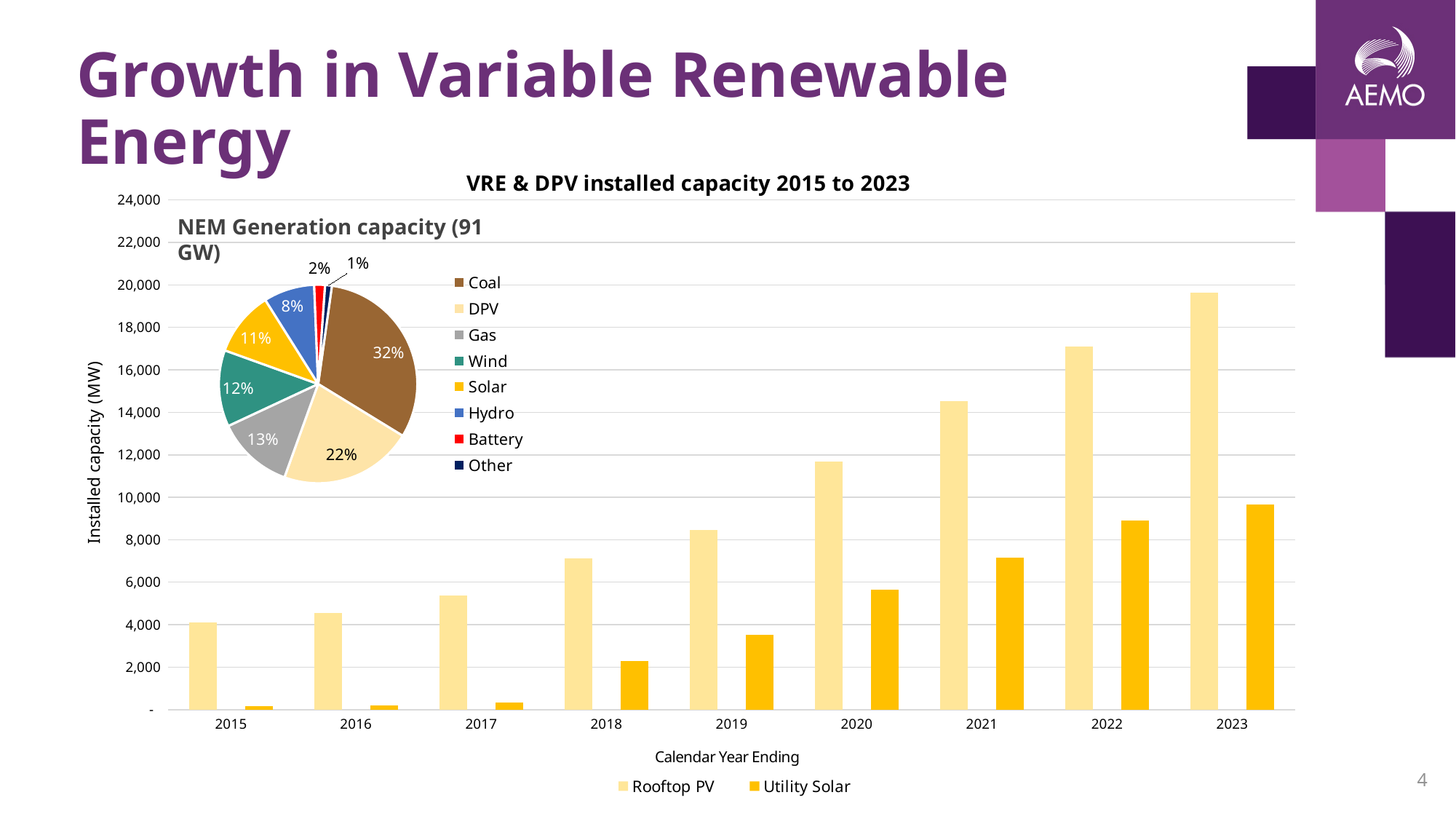
In the pie chart 'NEM Generation capacity (91 GW)', what share does Coal have? 32% In the pie chart 'NEM Generation capacity (91 GW)', what is the difference between the Gas share and the Hydro share? 5% In the chart 'VRE & DPV installed capacity 2015 to 2023', how many calendar years are shown on the x axis? 9 In the chart 'VRE & DPV installed capacity 2015 to 2023', how many series does the legend list? 2 In the pie chart 'NEM Generation capacity (91 GW)', which category has the largest share? Coal In the chart 'VRE & DPV installed capacity 2015 to 2023', is the Rooftop PV value for 2023 greater or less than 18,000? greater In the chart 'VRE & DPV installed capacity 2015 to 2023', what kind of chart is used? bar chart In the pie chart 'NEM Generation capacity (91 GW)', what share does Wind have? 12% In the pie chart 'NEM Generation capacity (91 GW)', which category has the smallest share? Other In the pie chart 'NEM Generation capacity (91 GW)', how many categories does the legend list? 8 In the pie chart 'NEM Generation capacity (91 GW)', what share does DPV have? 22% In the chart 'VRE & DPV installed capacity 2015 to 2023', does Utility Solar capacity rise or fall from 2015 to 2023? rise